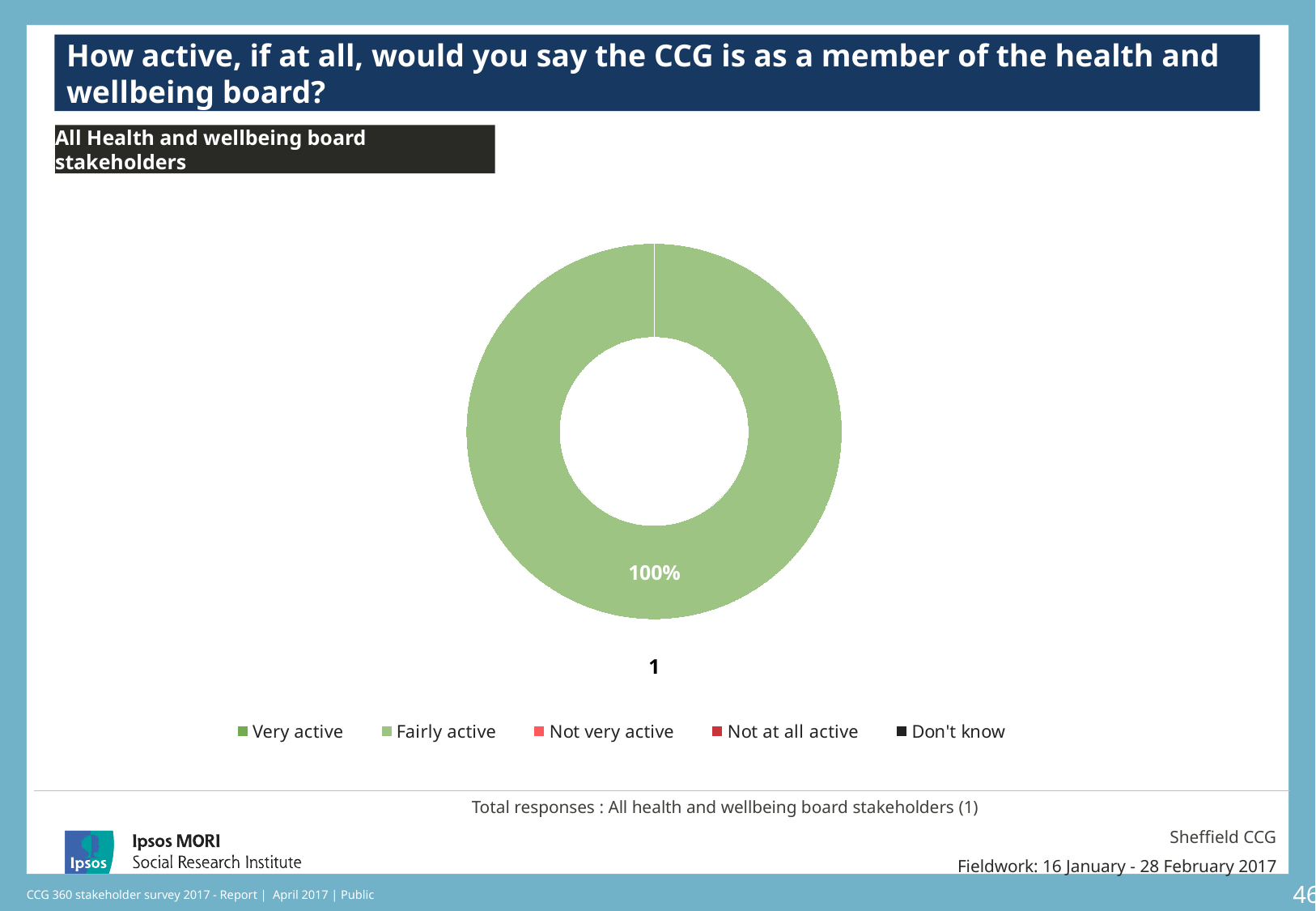
What question is shown as the title above the chart? How active, if at all, would you say the CCG is as a member of the health and wellbeing board? How many slices are visible in the doughnut chart? 1 What percentage is printed on the single slice of the doughnut chart? 100% Which legend category does the single slice of the doughnut chart represent? Fairly active How many entries does the chart legend list? 5 Which category has the largest share of the doughnut chart? Fairly active What share of the doughnut chart is taken by the Fairly active category? 100% What kind of chart is shown on the slide? doughnut chart